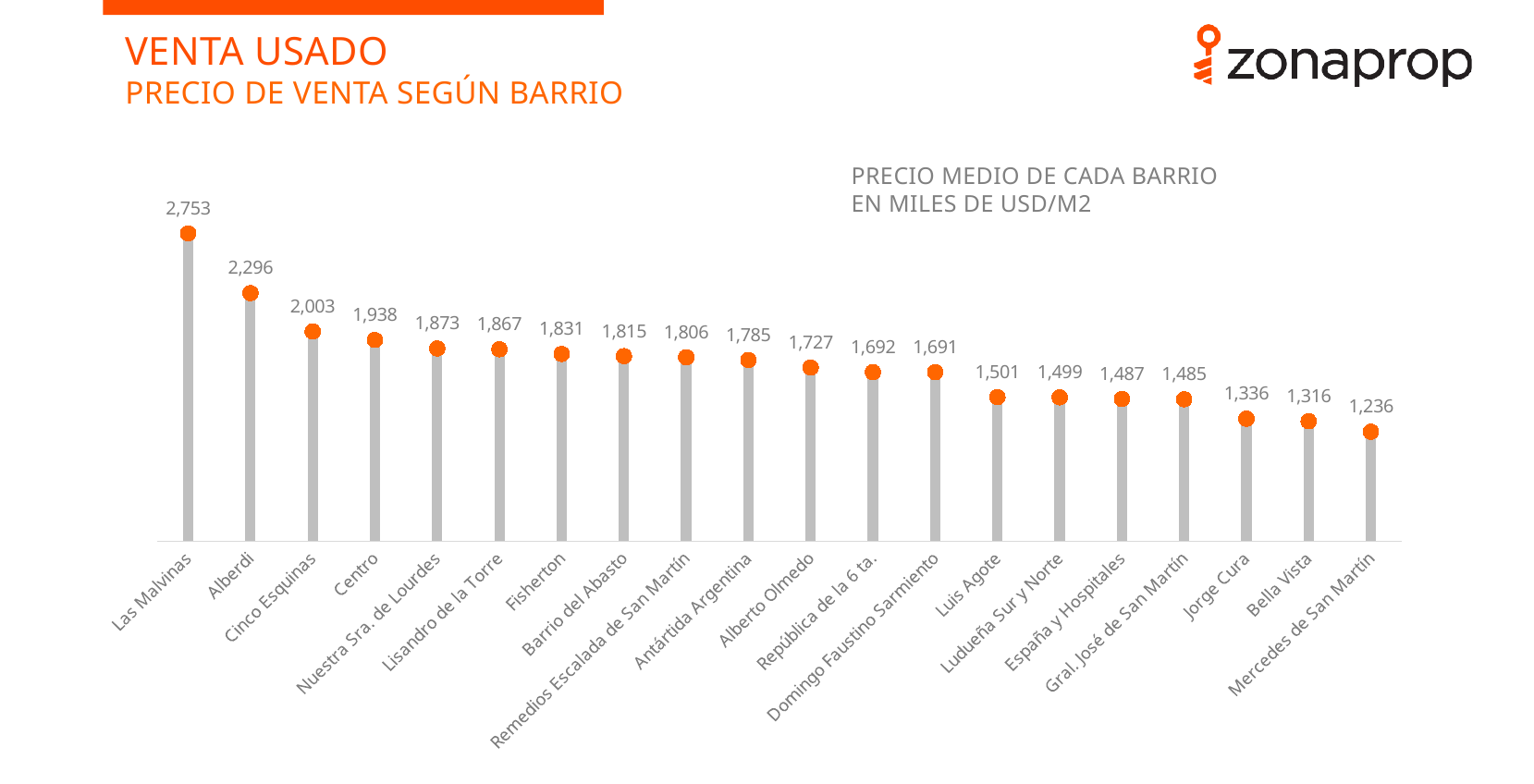
How many barrios are shown on the chart? 20 What is the value for Jorge Cura? 1,336 Which is larger, the value for Cinco Esquinas or the value for Luis Agote? Cinco Esquinas What is the value for Domingo Faustino Sarmiento? 1,691 What is the difference between the values for Centro and Bella Vista? 622 What is the value for Fisherton? 1,831 Do the values rise or fall from left to right along the x axis? Fall What is the value for Las Malvinas? 2,753 What is the difference between the values for Las Malvinas and Alberdi? 457 Which barrio has the highest value? Las Malvinas Which barrio has the lowest value? Mercedes de San Martín What kind of chart is this? Bar chart